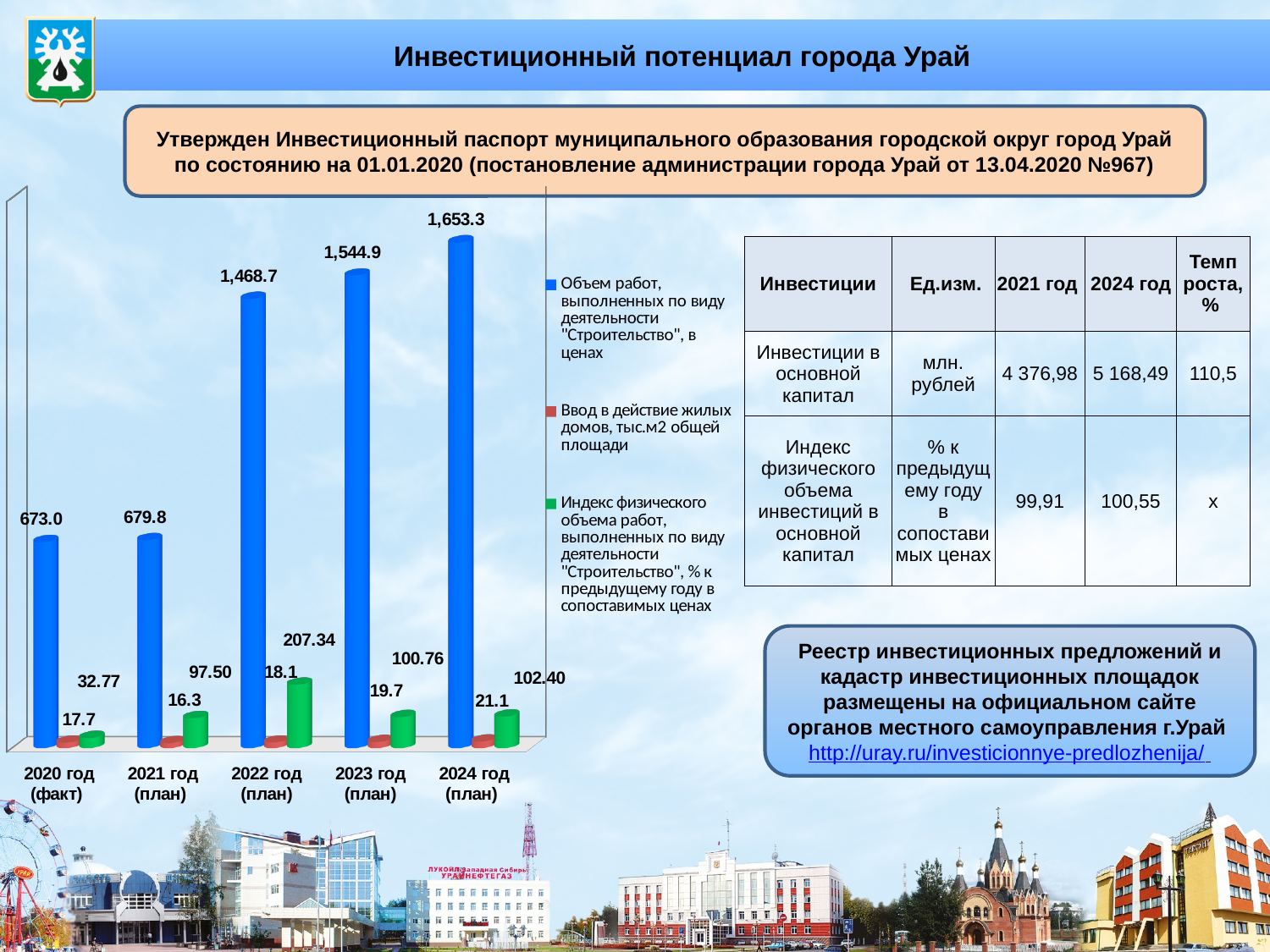
In which year is the blue series (Объем работ по виду деятельности "Строительство") highest? 2024 год (план) What is the difference between the blue series values for 2024 год (план) and 2023 год (план)? 108.4 Which is larger: the green series value for 2021 год (план) or for 2023 год (план)? 2023 год (план) What is the value of the green series (Индекс физического объема работ) for 2022 год (план)? 207.34 Does the blue series (Объем работ по виду деятельности "Строительство") rise or fall from 2020 год to 2024 год? rise What is the value of the blue series (Объем работ, выполненных по виду деятельности "Строительство") for 2020 год (факт)? 673.0 How many year categories are shown on the x axis of the chart? 5 In which year is the green series (Индекс физического объема работ) lowest? 2020 год (факт) What is the value of the red series (Ввод в действие жилых домов) for 2024 год (план)? 21.1 What is the value of the blue series (Объем работ, выполненных по виду деятельности "Строительство") for 2024 год (план)? 1,653.3 What type of chart is shown on the slide? bar chart How many series does the chart legend list? 3